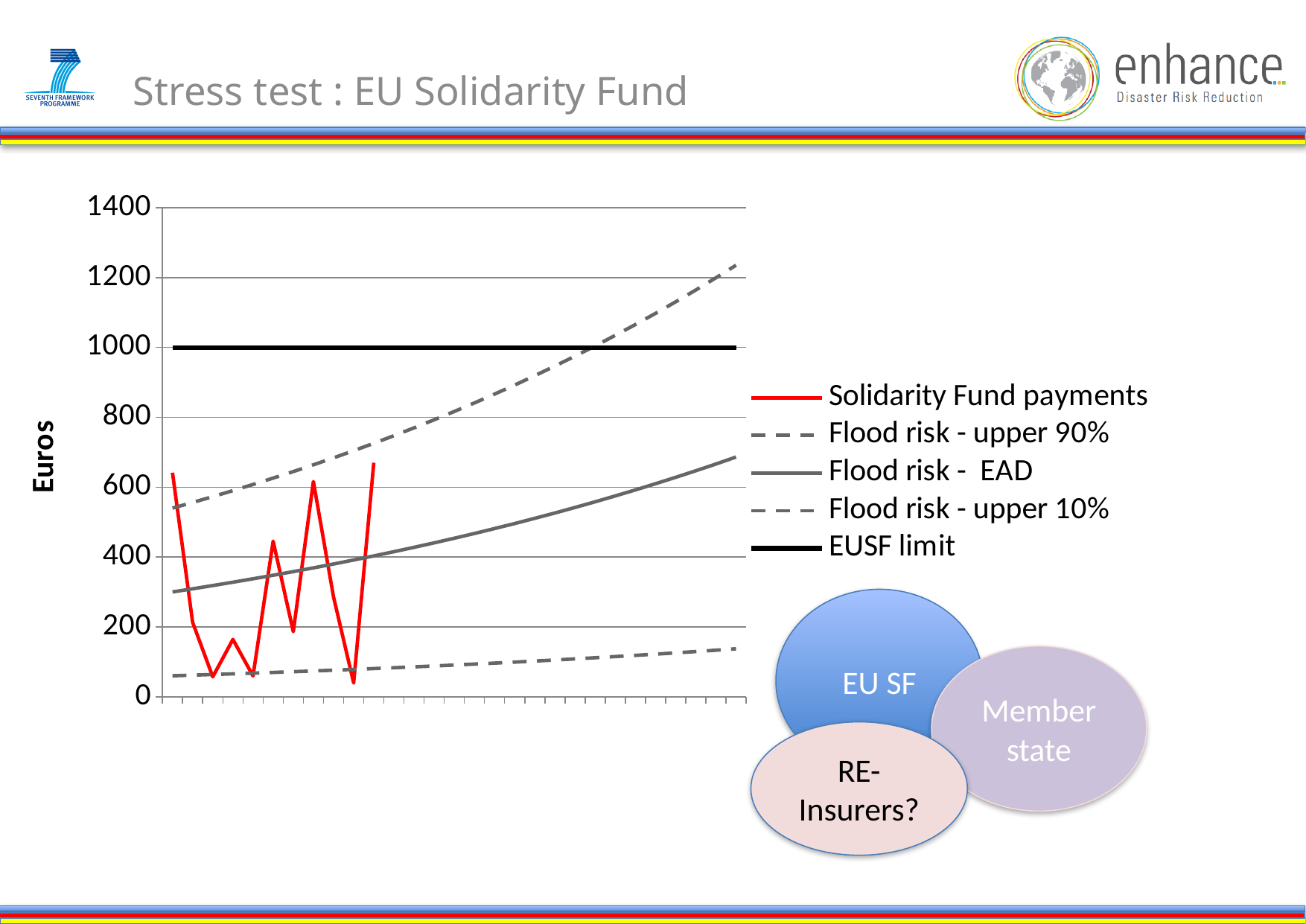
What kind of chart is shown on the slide? line chart Which series reaches the highest value on the chart? Flood risk - upper 90% At the right end of the chart, is the value of Flood risk - EAD greater or less than 800? less What is the label on the vertical axis of the chart? Euros Which series is drawn in red on the chart? Solidarity Fund payments What is the value of the EUSF limit line? 1000 At the right end of the chart, which is larger: Flood risk - upper 90% or Flood risk - EAD? Flood risk - upper 90% Does the Flood risk - upper 90% line rise or fall along the x axis? rise At the right end of the chart, is the value of Flood risk - upper 90% greater or less than 1000? greater At the right end of the chart, is the value of Flood risk - upper 10% greater or less than 200? less Does the Flood risk - EAD line rise or fall along the x axis? rise How many series does the chart legend list? 5